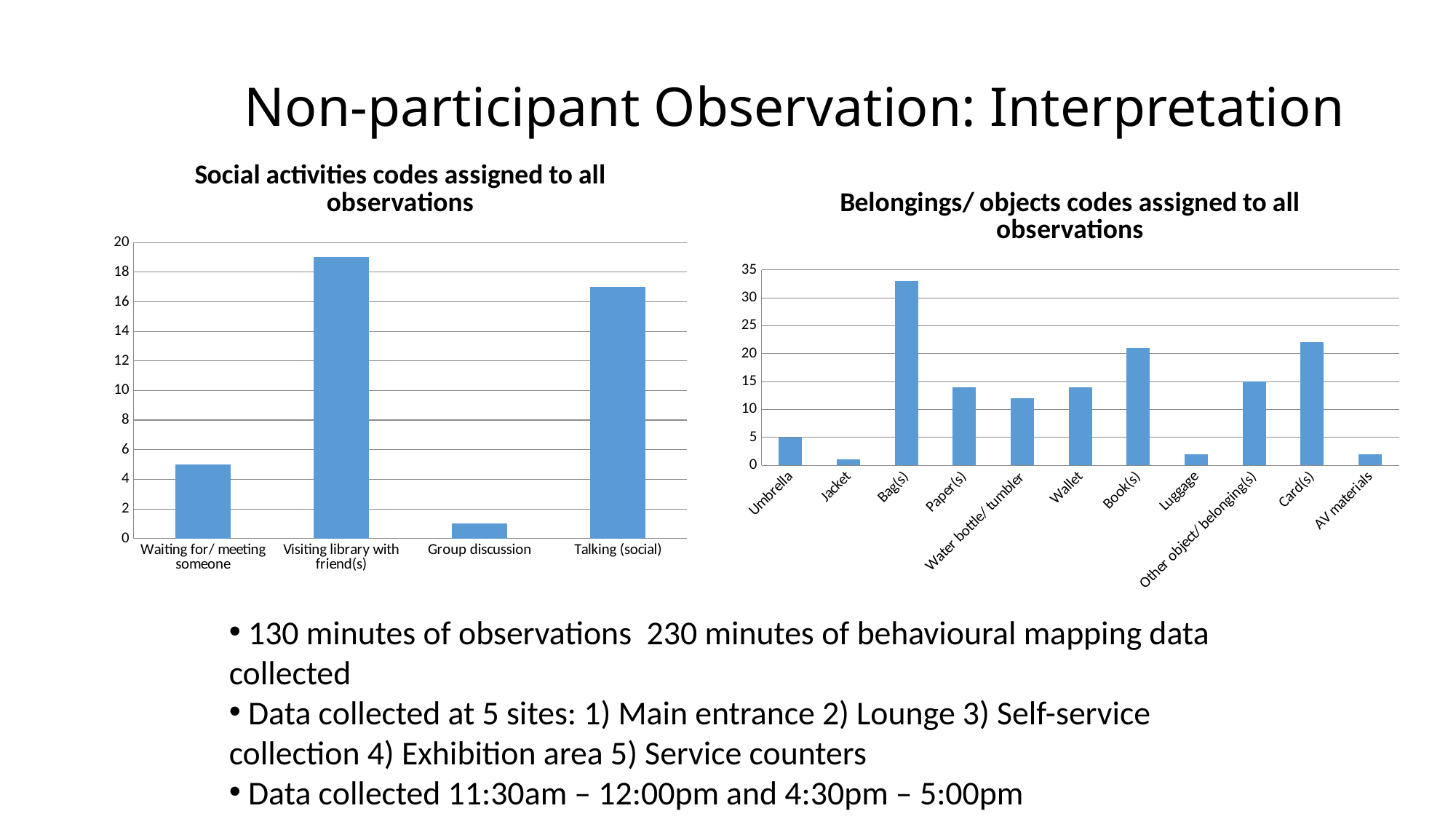
In the 'Social activities codes assigned to all observations' chart, is the value for 'Waiting for/ meeting someone' greater or less than 10? less In the 'Belongings/ objects codes assigned to all observations' chart, which category has the highest value? Bag(s) In the 'Belongings/ objects codes assigned to all observations' chart, which category has the lowest value? Jacket In the 'Social activities codes assigned to all observations' chart, how many categories are shown? 4 In the 'Social activities codes assigned to all observations' chart, which is larger: 'Visiting library with friend(s)' or 'Talking (social)'? Visiting library with friend(s) What kind of chart is the 'Social activities codes assigned to all observations' chart? bar chart In the 'Belongings/ objects codes assigned to all observations' chart, which is larger: 'Card(s)' or 'Other object/ belonging(s)'? Card(s) In the 'Belongings/ objects codes assigned to all observations' chart, how many categories are shown? 11 In the 'Belongings/ objects codes assigned to all observations' chart, what is the value for 'Umbrella'? 5 In the 'Belongings/ objects codes assigned to all observations' chart, is the value for 'Bag(s)' greater or less than 30? greater In the 'Social activities codes assigned to all observations' chart, which category has the lowest value? Group discussion In the 'Social activities codes assigned to all observations' chart, which category has the highest value? Visiting library with friend(s)